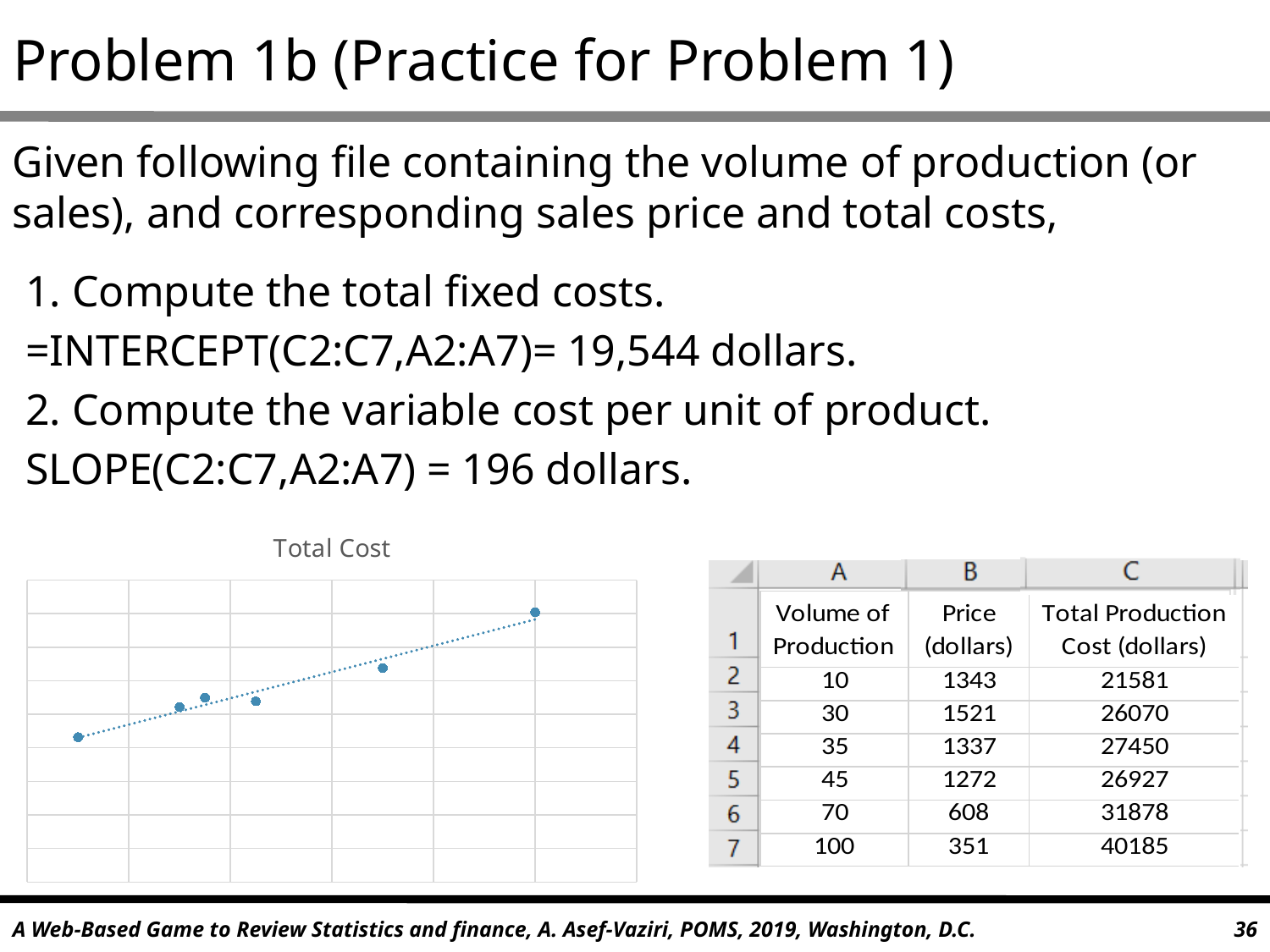
What kind of chart is the chart titled "Total Cost"? scatter chart In the "Total Cost" chart, do the plotted values rise or fall as you move from left to right along the x axis? rise What is the title of the chart on the slide? Total Cost How many data points are plotted in the "Total Cost" chart? 6 In the "Total Cost" chart, is the highest point the leftmost or the rightmost point? rightmost Does the "Total Cost" chart include a trendline through the points? Yes, a dotted trendline In the "Total Cost" chart, is the lowest point the leftmost or the rightmost point? leftmost In the "Total Cost" chart, which is higher: the rightmost point or the second point from the right? the rightmost point